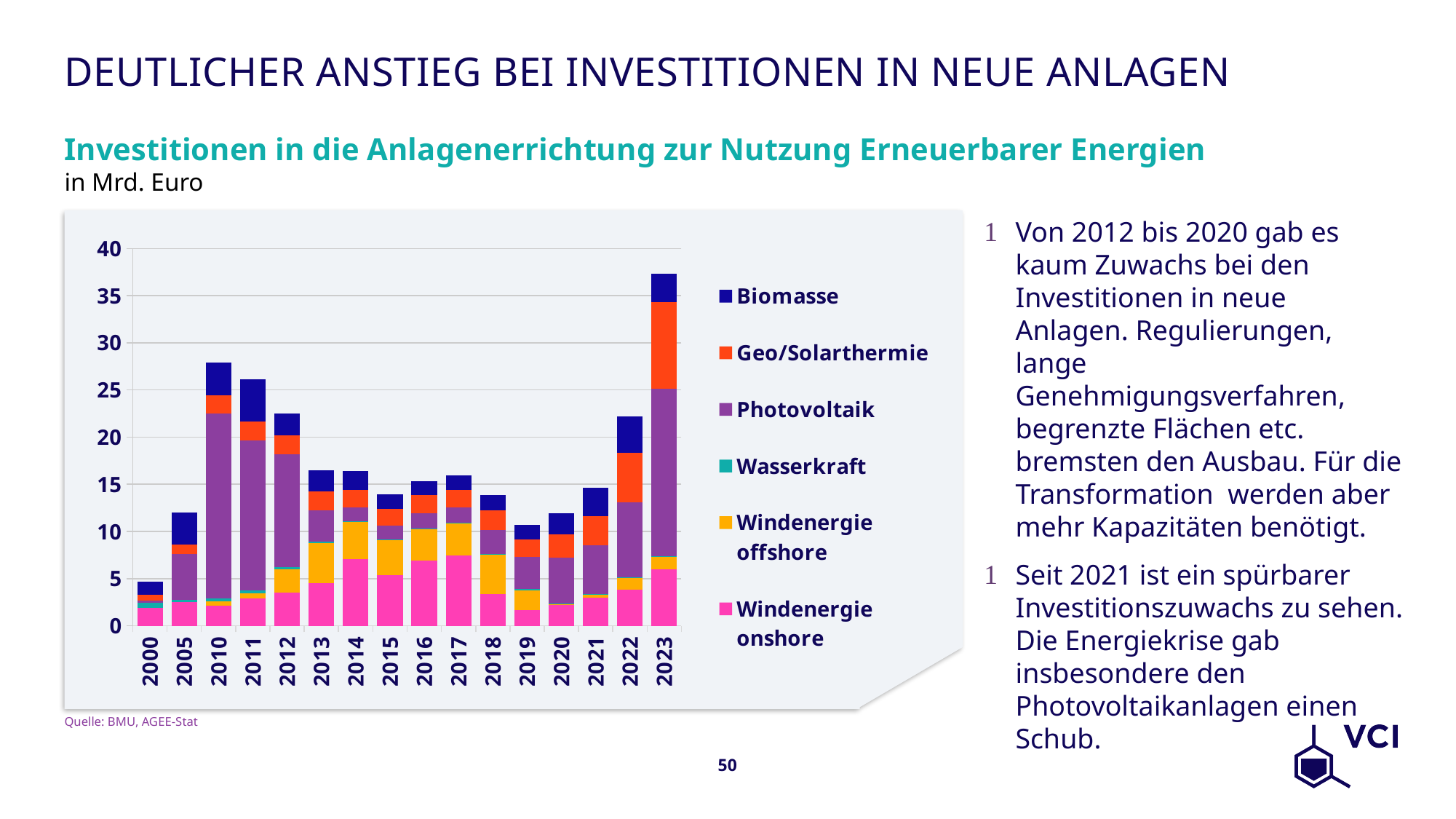
Is the total value for 2010 greater or less than 25? greater Which year has the larger total investment, 2012 or 2013? 2012 Is the total value for 2019 greater or less than 15? less What kind of chart is shown on the slide? Stacked bar chart How many series does the chart legend list? 6 How many years are shown on the x axis of the chart? 16 Do the total values rise or fall from 2020 to 2023? rise Which year has the highest total investment in the chart? 2023 Which series is shown in pink at the bottom of each bar? Windenergie onshore Which year has the larger total investment, 2010 or 2011? 2010 Which year has the lowest total investment in the chart? 2000 Is the total value for 2023 greater or less than 35? greater